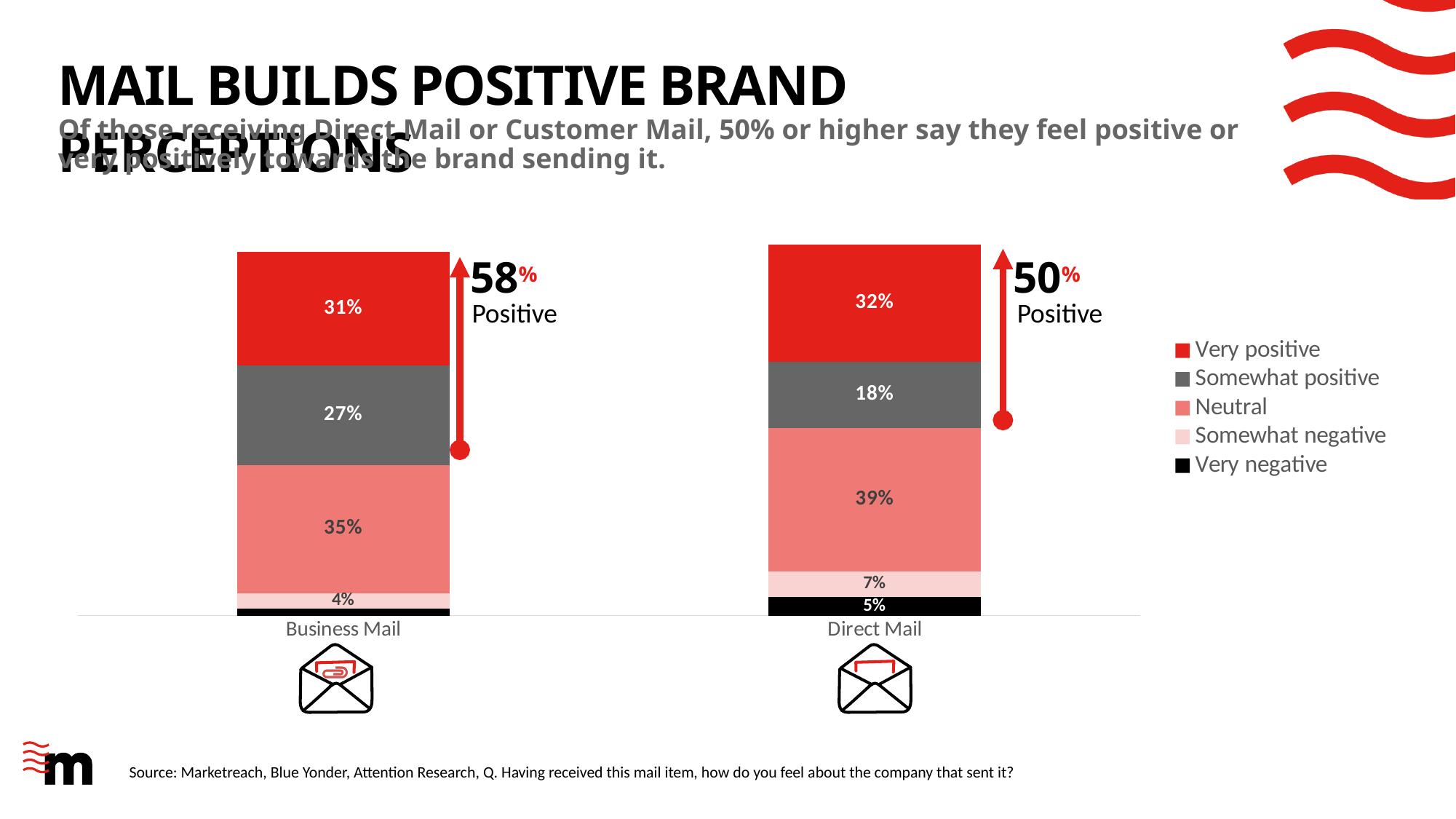
What is the Somewhat negative value for Business Mail? 4% Which segment is the largest in the Direct Mail bar? Neutral How many series does the legend list? 5 What is the Somewhat positive value for Direct Mail? 18% What is the difference between the Somewhat positive values for Business Mail and Direct Mail? 9 percentage points What percentage of Direct Mail recipients are Very positive? 32% Which category has the larger Neutral value, Business Mail or Direct Mail? Direct Mail What is the Neutral value for Business Mail? 35% What kind of chart is shown on the slide? Stacked bar chart What is the difference between the annotated Positive totals for Business Mail (58%) and Direct Mail (50%)? 8 percentage points What is the Very negative value for Direct Mail? 5% What total Positive percentage is annotated for Business Mail? 58%